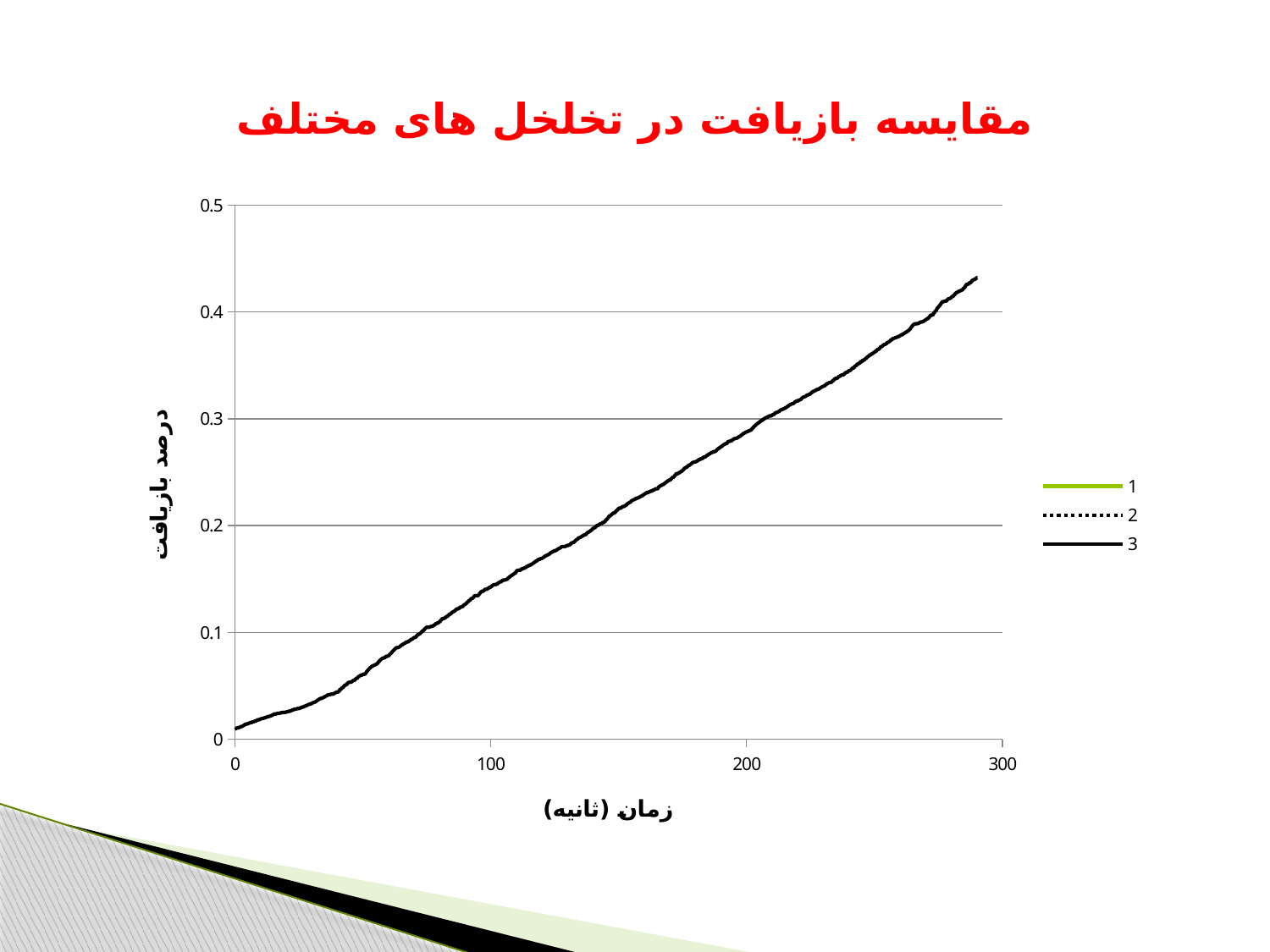
Does the plotted line for series 3 rise or fall as time increases along the x axis? rise Is the value of series 3 at time 100 greater or less than 0.2? less What kind of chart is shown on the slide? line chart How many series does the legend list? 3 Is the value of series 3 at time 250 greater or less than 0.3? greater What are the entries listed in the chart legend? 1, 2, 3 Is the highest value reached by series 3 greater or less than 0.4? greater What is the title of the chart? مقایسه بازیافت در تخلخل های مختلف